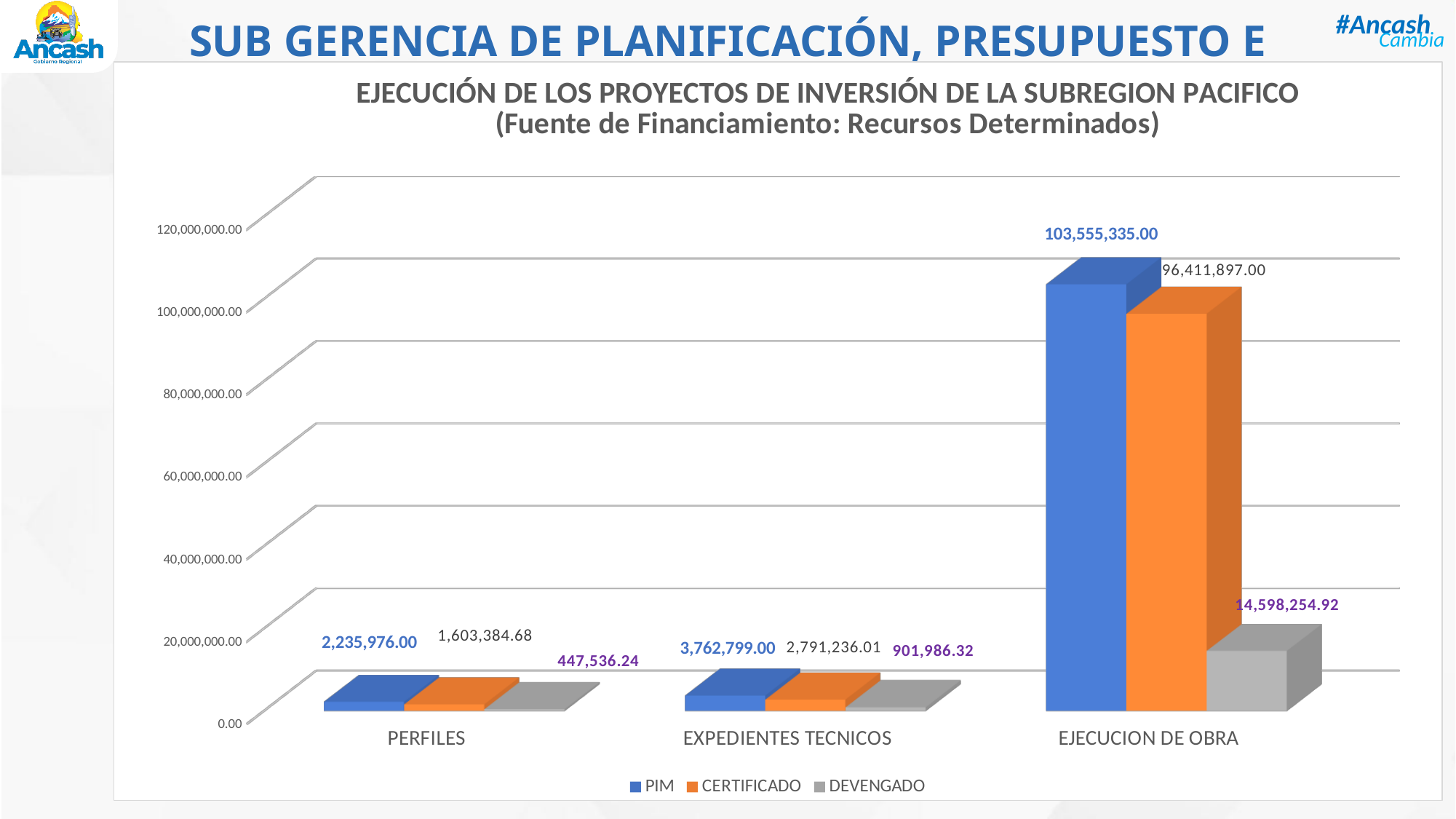
Which is larger, the CERTIFICADO value for EXPEDIENTES TECNICOS or the CERTIFICADO value for PERFILES? EXPEDIENTES TECNICOS What is the DEVENGADO value for EXPEDIENTES TECNICOS? 901,986.32 What is the difference between the PIM and DEVENGADO values for PERFILES? 1,788,439.76 What kind of chart is shown on the slide? Bar chart What is the difference between the PIM and CERTIFICADO values for EJECUCION DE OBRA? 7,143,438.00 How many series does the legend list? 3 Which category has the lowest DEVENGADO value? PERFILES Which category has the highest PIM value? EJECUCION DE OBRA How many categories are shown on the x axis? 3 What is the CERTIFICADO value for PERFILES? 1,603,384.68 What is the PIM value for EJECUCION DE OBRA? 103,555,335.00 What is the DEVENGADO value for EJECUCION DE OBRA? 14,598,254.92